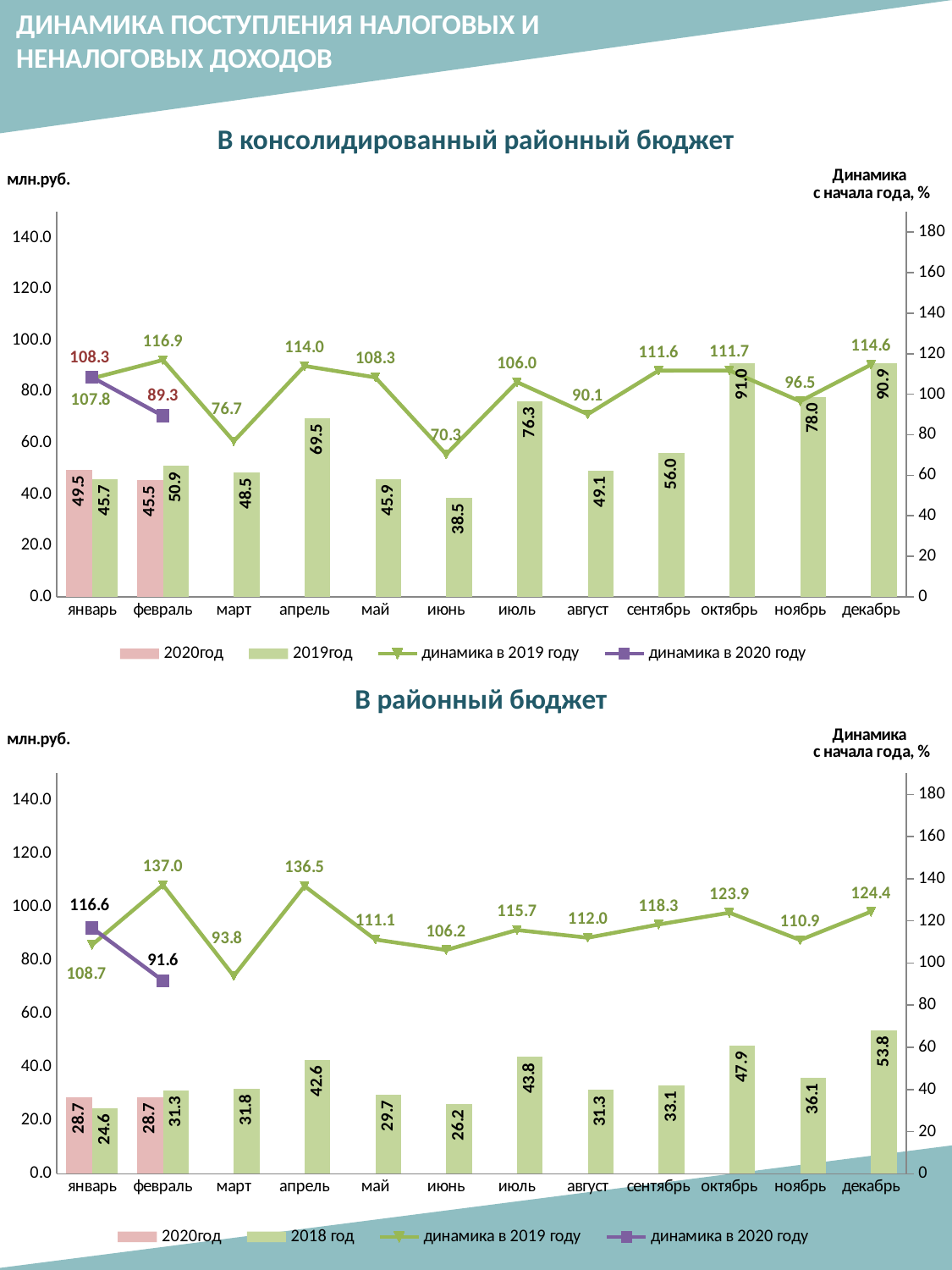
In the chart 'В консолидированный районный бюджет', how many series does the legend list? 4 In the chart 'В районный бюджет', what is the value of the 2018 bar for декабрь? 53.8 In the chart 'В консолидированный районный бюджет', which month has the lowest 2019 bar? июнь In the chart 'В районный бюджет', which month has the highest value of 'динамика в 2019 году'? февраль In the chart 'В консолидированный районный бюджет', what is the difference between the 2020 and 2019 bars for январь? 3.8 In the chart 'В консолидированный районный бюджет', which is larger for февраль: the 2020 bar or the 2019 bar? 2019 bar In the chart 'В районный бюджет', what is the value of 'динамика в 2020 году' for январь? 116.6 In the chart 'В районный бюджет', how many months are shown on the x axis? 12 What kind of chart is 'В районный бюджет'? Combined bar and line chart In the chart 'В консолидированный районный бюджет', what is the value of the 2019 bar for октябрь? 91.0 In the chart 'В районный бюджет', what is the difference between the 2018 bars for октябрь and ноябрь? 11.8 In the chart 'В консолидированный районный бюджет', what is the value of 'динамика в 2020 году' for февраль? 89.3